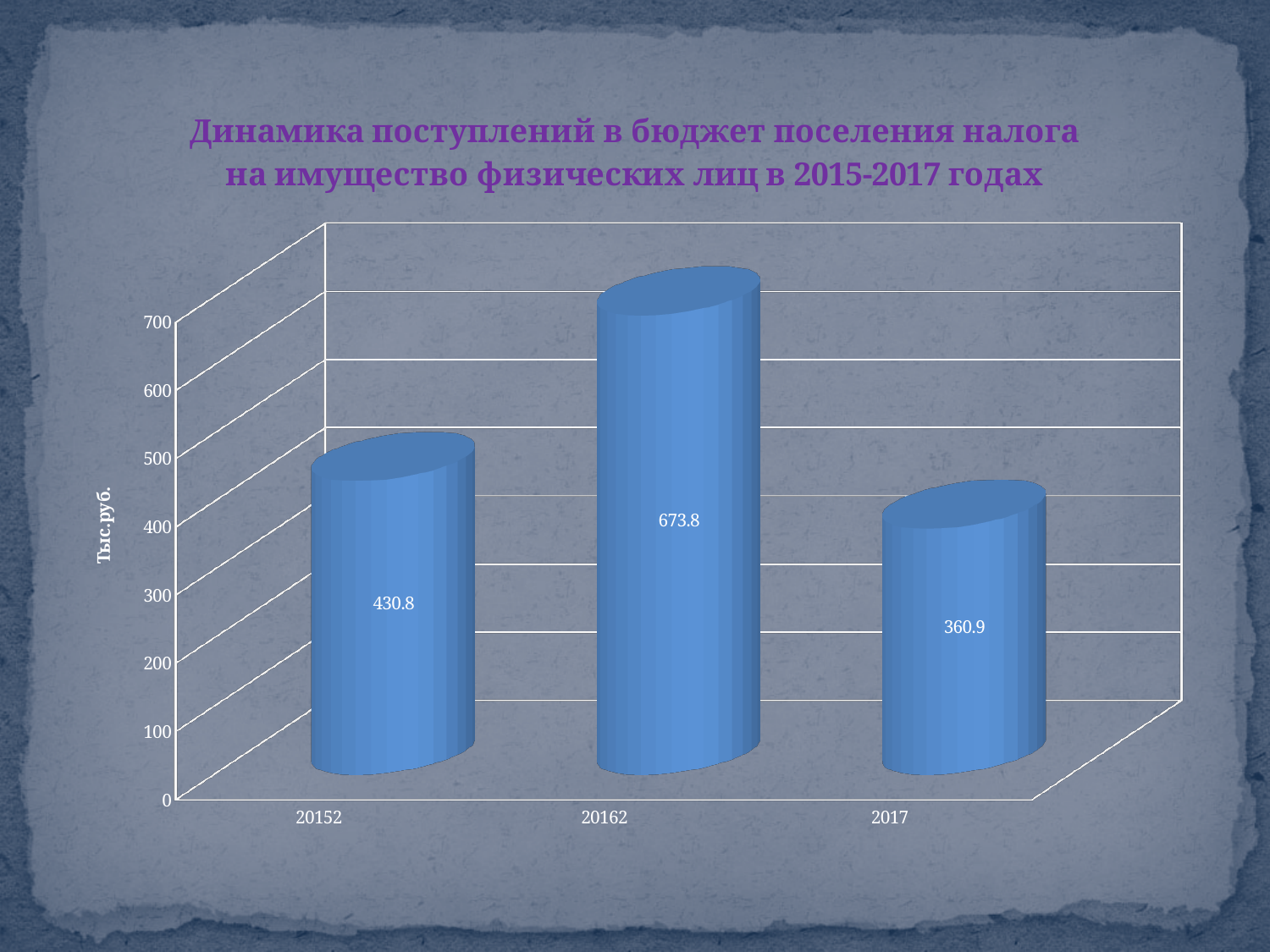
Is the value for 20162 greater or less than 600? greater Which category has the lowest value? 2017 Which category has the highest value? 20162 What is the value for 2017? 360.9 Which is larger, the value for 20152 or the value for 2017? 20152 What kind of chart is shown on the slide? bar chart How many categories are shown on the x axis? 3 What is the value for the category labelled 20162? 673.8 What is the difference between the values for 20152 and 2017? 69.9 What is the difference between the values for 20162 and 20152? 243.0 What is the value for the category labelled 20152? 430.8 What is the label of the vertical axis? Тыс.руб.